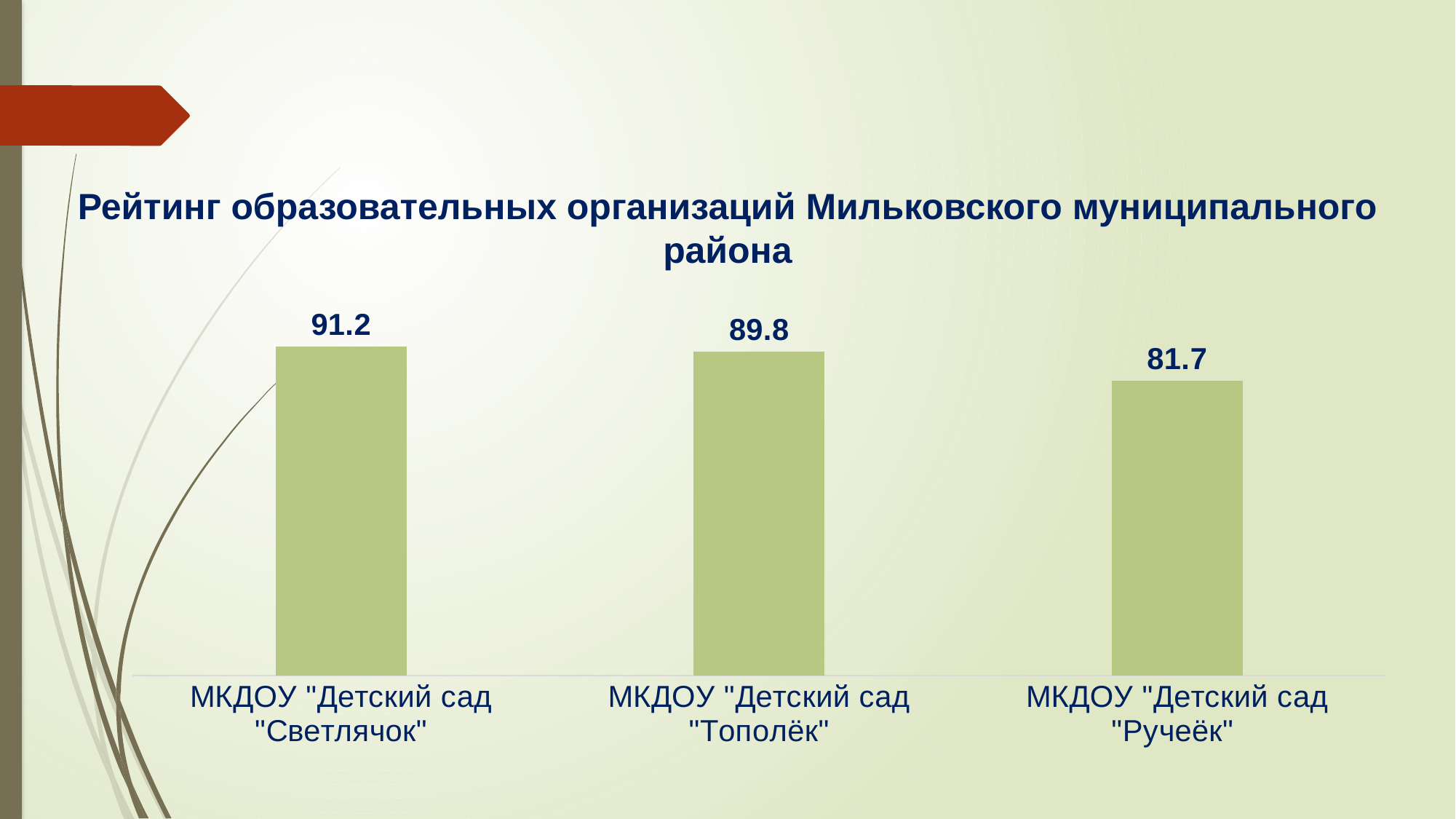
How many organisations are shown in the chart? 3 Which has a larger value, "Тополёк" or "Ручеёк"? МКДОУ "Детский сад "Тополёк" What kind of chart is shown on the slide? Bar chart What is the difference between the values for "Светлячок" and "Ручеёк"? 9.5 What is the value for МКДОУ "Детский сад "Тополёк"? 89.8 What is the value for МКДОУ "Детский сад "Светлячок"? 91.2 What is the title of the chart? Рейтинг образовательных организаций Мильковского муниципального района What is the value for МКДОУ "Детский сад "Ручеёк"? 81.7 What is the difference between the values for "Светлячок" and "Тополёк"? 1.4 Do the values rise or fall from left to right across the chart? Fall Which organisation has the highest value? МКДОУ "Детский сад "Светлячок" Which organisation has the lowest value? МКДОУ "Детский сад "Ручеёк"